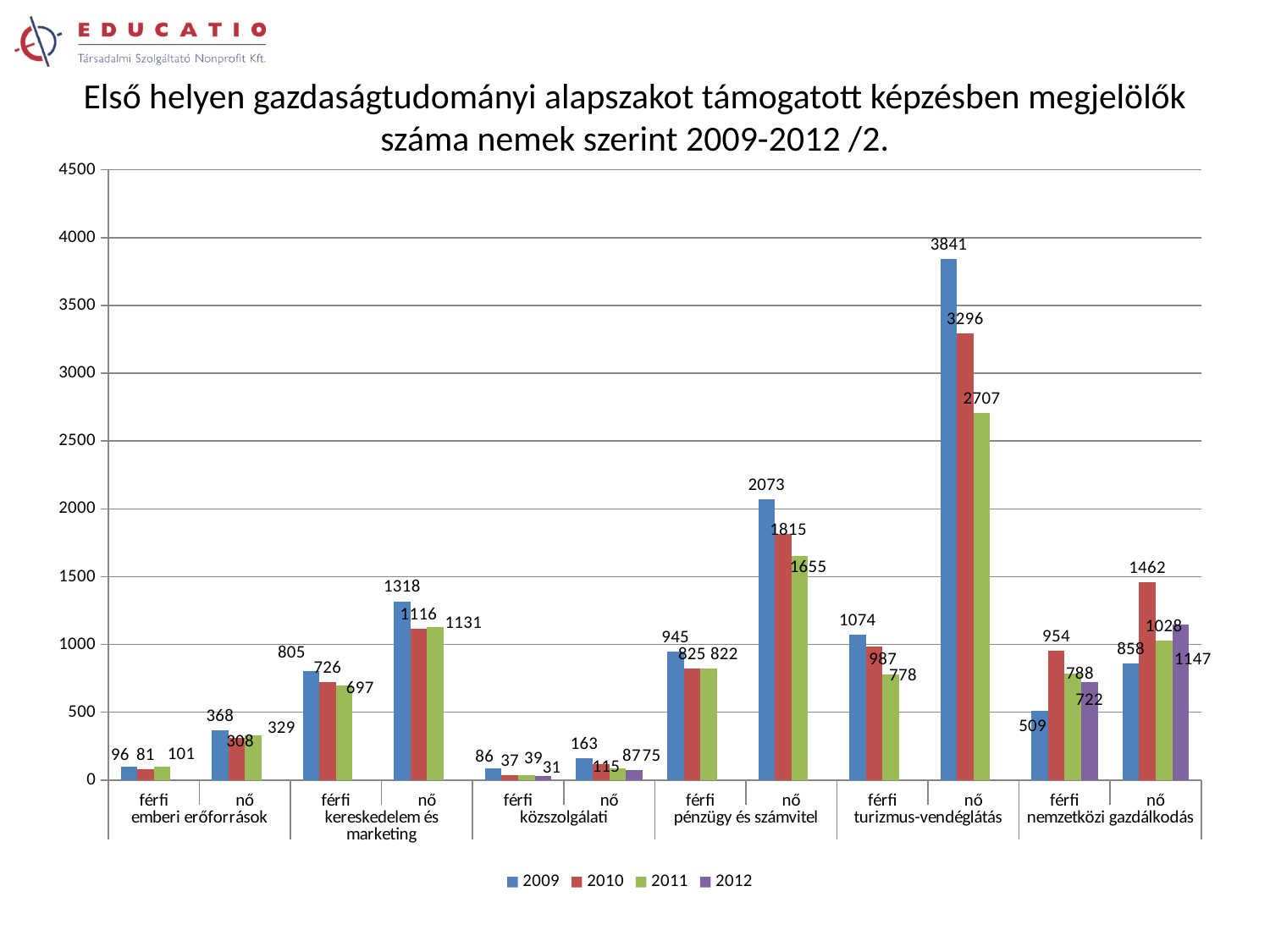
What is the 2011 value for férfi in kereskedelem és marketing? 697 What kind of chart is shown on the slide? bar chart What is the 2010 value for nő in nemzetközi gazdálkodás? 1462 Which year is shown in green in the legend? 2011 Which category and gender has the highest 2009 value? turizmus-vendéglátás nő Do the values for nő in turizmus-vendéglátás rise or fall from 2009 to 2011? fall How many study fields (category groups) are shown on the x axis? 6 How many series does the legend list? 4 What is the 2012 value for férfi in közszolgálati? 31 What is the difference between the 2009 and 2010 values for nő in pénzügy és számvitel? 258 What is the 2009 value for nő in turizmus-vendéglátás? 3841 Which is larger: the 2010 value for férfi in nemzetközi gazdálkodás or the 2010 value for férfi in turizmus-vendéglátás? turizmus-vendéglátás férfi (987)